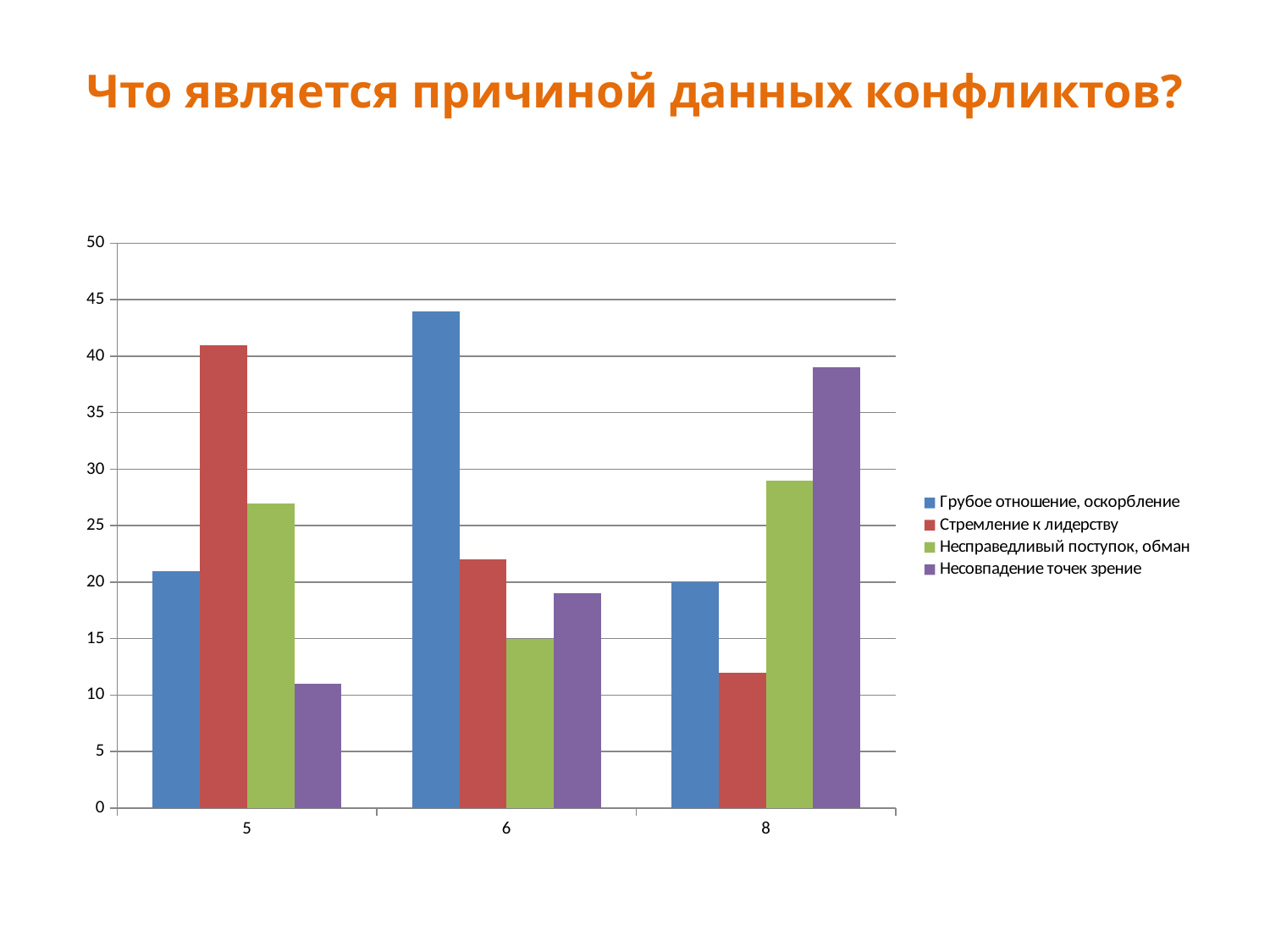
Which series has the highest value for category 5? Стремление к лидерству How many categories are shown on the x axis? 3 Which series has the highest value for category 6? Грубое отношение, оскорбление What kind of chart is shown on the slide? bar chart For category 8, which is larger: Несправедливый поступок, обман or Грубое отношение, оскорбление? Несправедливый поступок, обман Which series has the highest value for category 8? Несовпадение точек зрение How many series does the legend list? 4 What is the title of the slide above the chart? Что является причиной данных конфликтов? Is the value for Грубое отношение, оскорбление in category 6 greater or less than 40? greater Which series is shown in purple in the legend? Несовпадение точек зрение Which series has the lowest value for category 8? Стремление к лидерству Which series has the lowest value for category 5? Несовпадение точек зрение